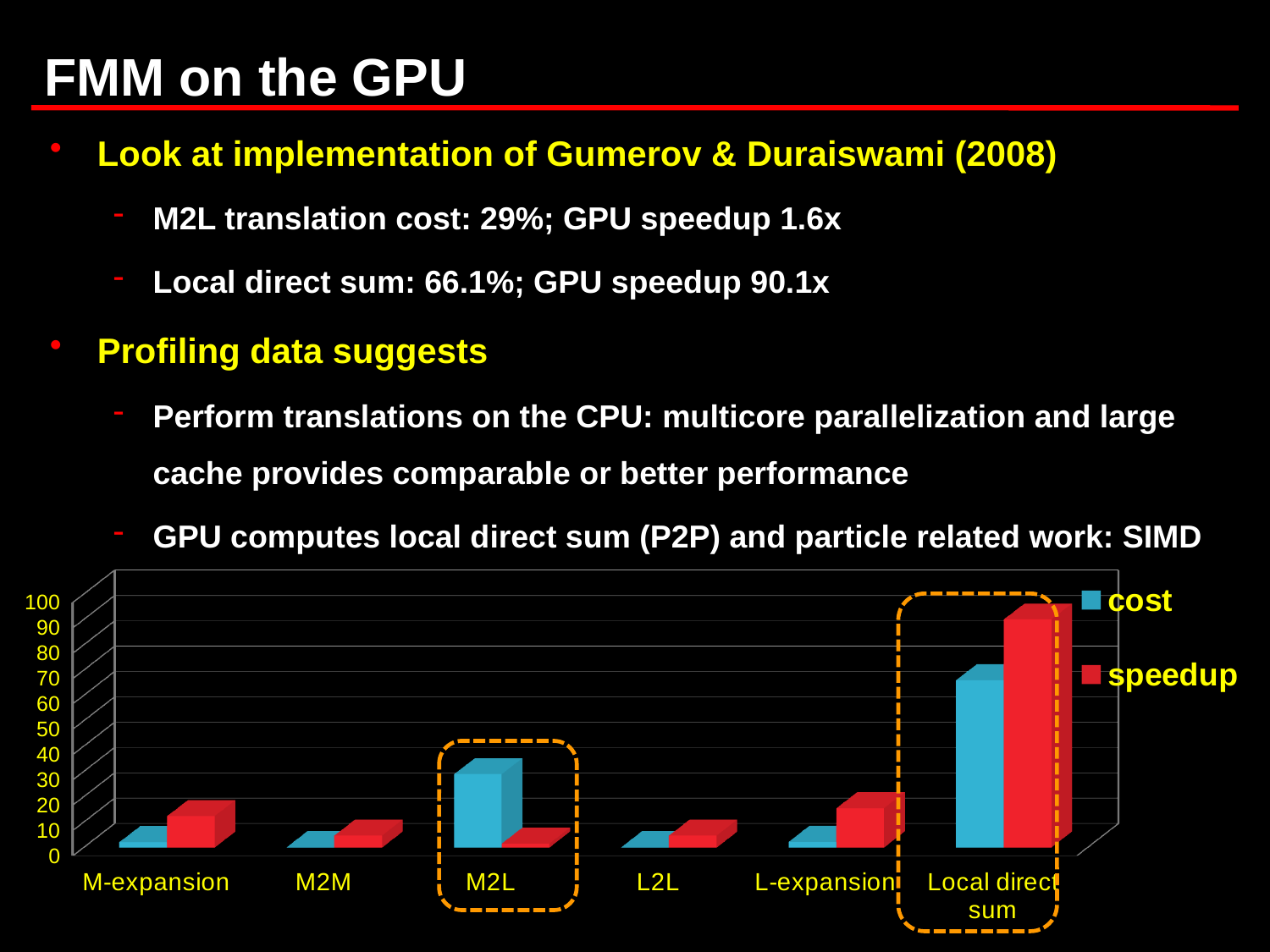
What kind of chart is shown on the slide? bar chart Which category has the highest speedup bar? Local direct sum How many series does the chart legend list? 2 Is the cost value for Local direct sum greater or less than 50? greater Which category has the highest cost bar? Local direct sum How many categories are shown on the x axis of the chart? 6 For Local direct sum, which is larger, the cost bar or the speedup bar? speedup Is the speedup value for Local direct sum greater or less than 80? greater What are the two series names listed in the chart legend? cost and speedup Is the speedup value for M2L greater or less than 10? less For M2L, which is larger, the cost bar or the speedup bar? cost